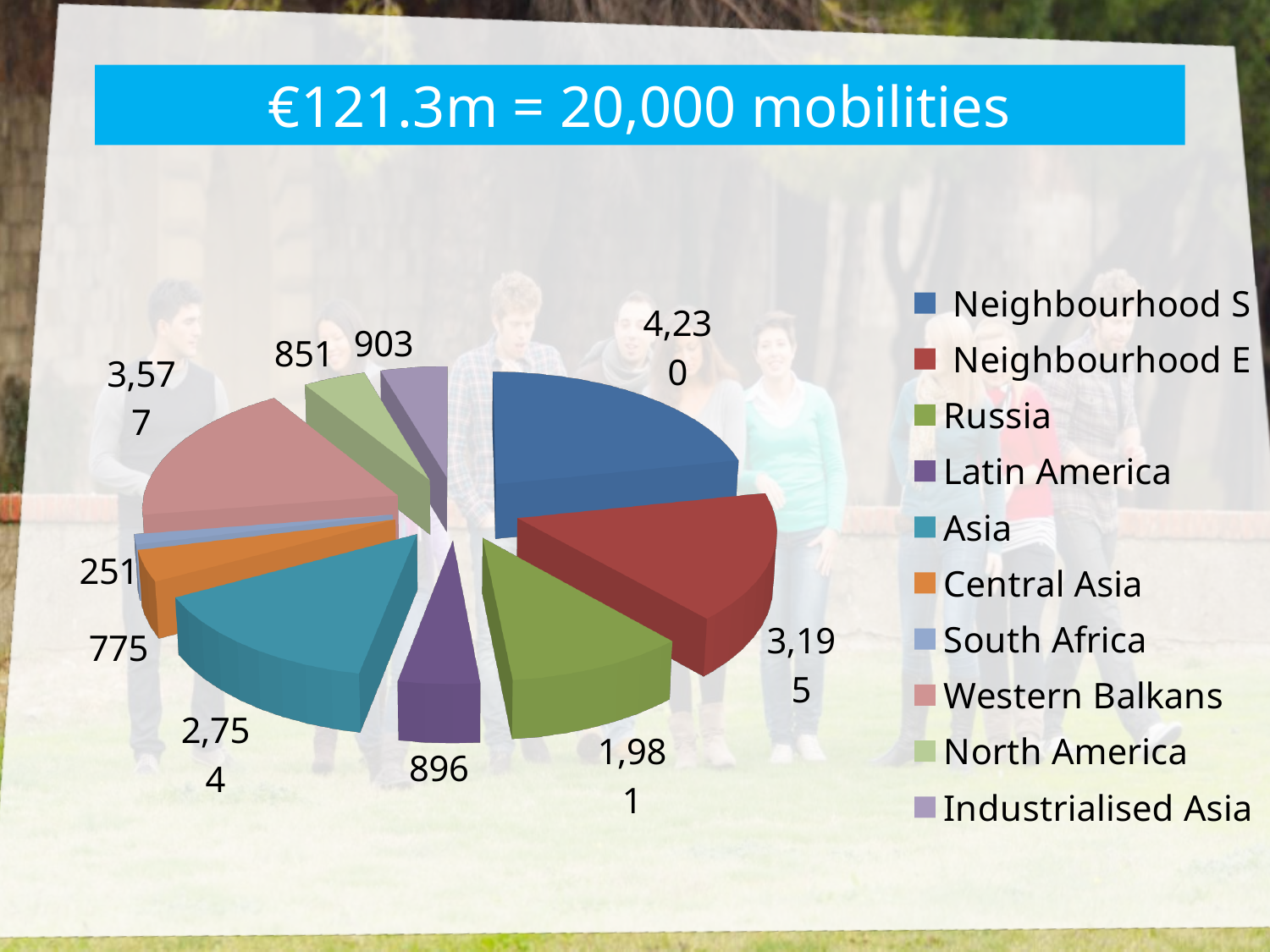
How many categories does the pie chart have? 10 What kind of chart is shown on the slide? pie chart What is the value for Neighbourhood S? 4,230 What is the value for Asia? 2,754 What is the title shown above the chart? €121.3m = 20,000 mobilities Which is larger, the value for Russia or the value for Latin America? Russia What is the value for South Africa? 251 Which category has the smallest slice of the pie? South Africa Which category has the largest slice of the pie? Neighbourhood S What is the value for Neighbourhood E? 3,195 What is the value for Western Balkans? 3,577 What is the difference between the values for Neighbourhood S and Neighbourhood E? 1,035